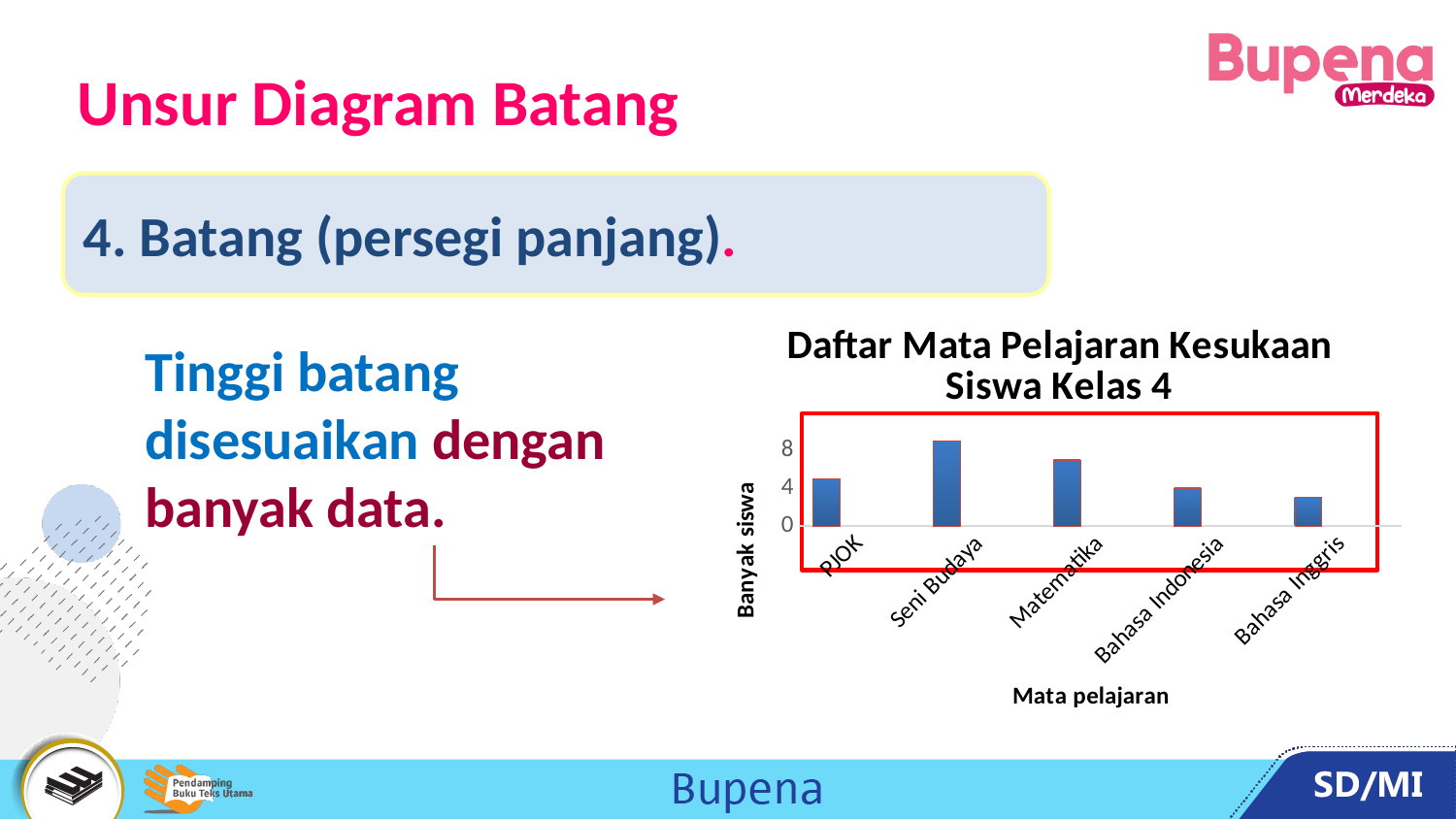
Which subject has the lowest bar in the chart? Bahasa Inggris Which subject has the highest bar in the chart? Seni Budaya How many subjects (categories) are shown in the chart? 5 What kind of chart is shown on the slide? bar chart Which has the larger value, Seni Budaya or PJOK? Seni Budaya Is the value for Bahasa Inggris greater or less than 4? less Is the value for Seni Budaya greater or less than 8? greater Is the value for PJOK greater or less than 4? greater Which has the larger value, Matematika or Bahasa Inggris? Matematika What is the label of the vertical axis of the chart? Banyak siswa What is the title of the chart? Daftar Mata Pelajaran Kesukaan Siswa Kelas 4